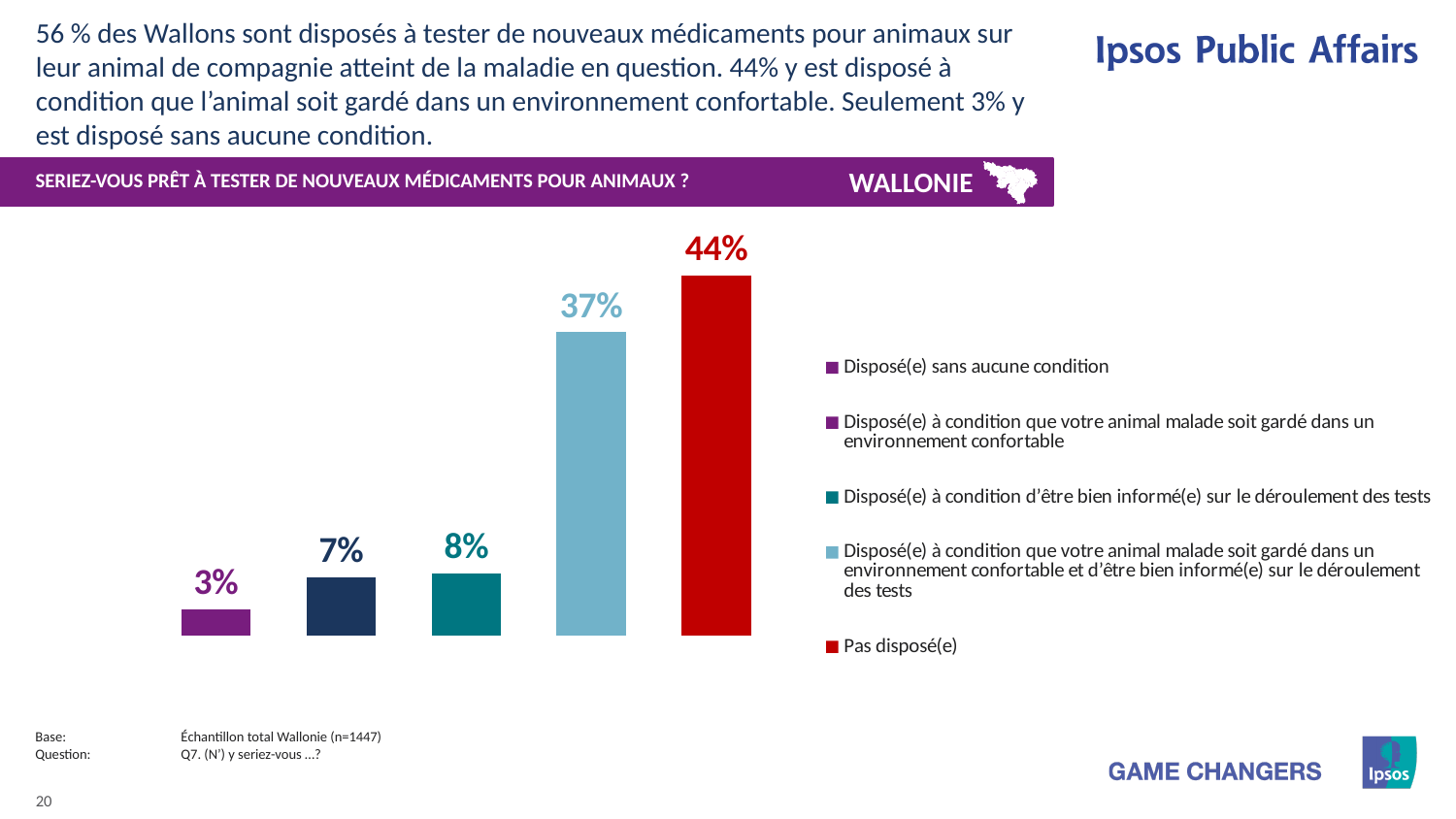
Which category has the lowest value in the chart? Disposé(e) sans aucune condition What percentage of respondents are 'Pas disposé(e)'? 44% How many entries does the legend list? 5 Which category has the highest value in the chart? Pas disposé(e) What percentage of respondents are 'Disposé(e) sans aucune condition'? 3% What is the difference between the 'Pas disposé(e)' value and the value for those willing on condition of both a comfortable environment and being well informed? 7% How many bars are shown in the chart? 5 What type of chart is shown on the slide? Bar chart What percentage of respondents are 'Disposé(e) à condition d'être bien informé(e) sur le déroulement des tests'? 8% What percentage of respondents are 'Disposé(e) à condition que votre animal malade soit gardé dans un environnement confortable et d'être bien informé(e) sur le déroulement des tests'? 37% What colour is the bar for 'Pas disposé(e)'? Red Which is larger: the value for 'Disposé(e) à condition que votre animal malade soit gardé dans un environnement confortable' or the value for 'Disposé(e) à condition d'être bien informé(e) sur le déroulement des tests'? Disposé(e) à condition d'être bien informé(e) sur le déroulement des tests